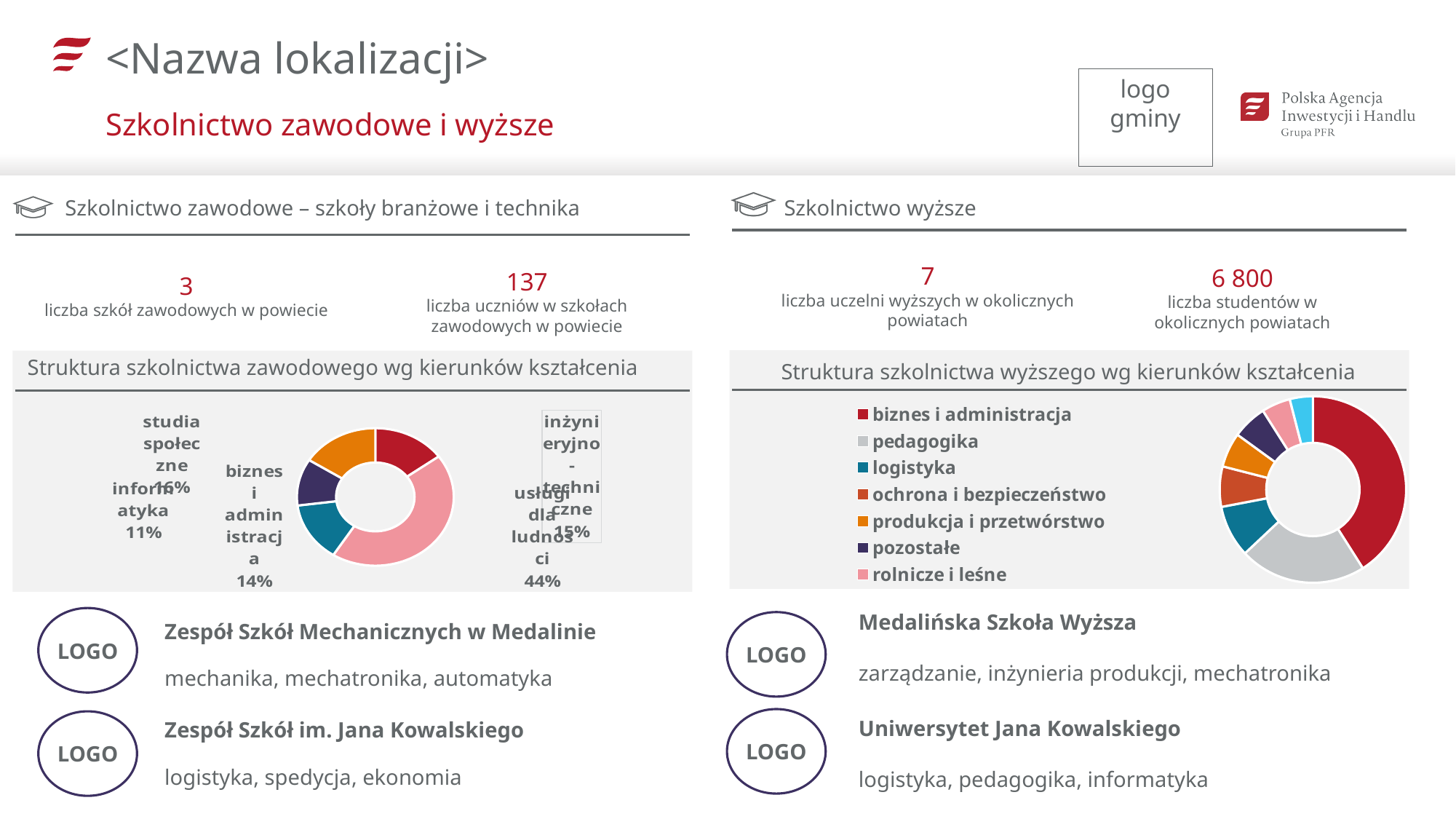
In the chart 'Struktura szkolnictwa zawodowego wg kierunków kształcenia', what share is shown for 'informatyka'? 11% How many categories are shown in the chart 'Struktura szkolnictwa zawodowego wg kierunków kształcenia'? 5 In the chart 'Struktura szkolnictwa zawodowego wg kierunków kształcenia', what share is shown for 'usługi dla ludności'? 44% What kind of chart is 'Struktura szkolnictwa zawodowego wg kierunków kształcenia'? doughnut chart In the chart 'Struktura szkolnictwa wyższego wg kierunków kształcenia', which slice is larger: 'biznes i administracja' or 'pedagogika'? biznes i administracja In the chart 'Struktura szkolnictwa zawodowego wg kierunków kształcenia', which is larger: 'studia społeczne' or 'biznes i administracja'? studia społeczne In the chart 'Struktura szkolnictwa wyższego wg kierunków kształcenia', which category has the largest slice? biznes i administracja In the chart 'Struktura szkolnictwa zawodowego wg kierunków kształcenia', how many percentage points larger is 'usługi dla ludności' than 'studia społeczne'? 28 In the chart 'Struktura szkolnictwa zawodowego wg kierunków kształcenia', which category has the largest share? usługi dla ludności How many entries does the legend of the chart 'Struktura szkolnictwa wyższego wg kierunków kształcenia' list? 7 In the chart 'Struktura szkolnictwa zawodowego wg kierunków kształcenia', what share is shown for 'inżynieryjno-techniczne'? 15% In the chart 'Struktura szkolnictwa zawodowego wg kierunków kształcenia', which category has the smallest share? informatyka